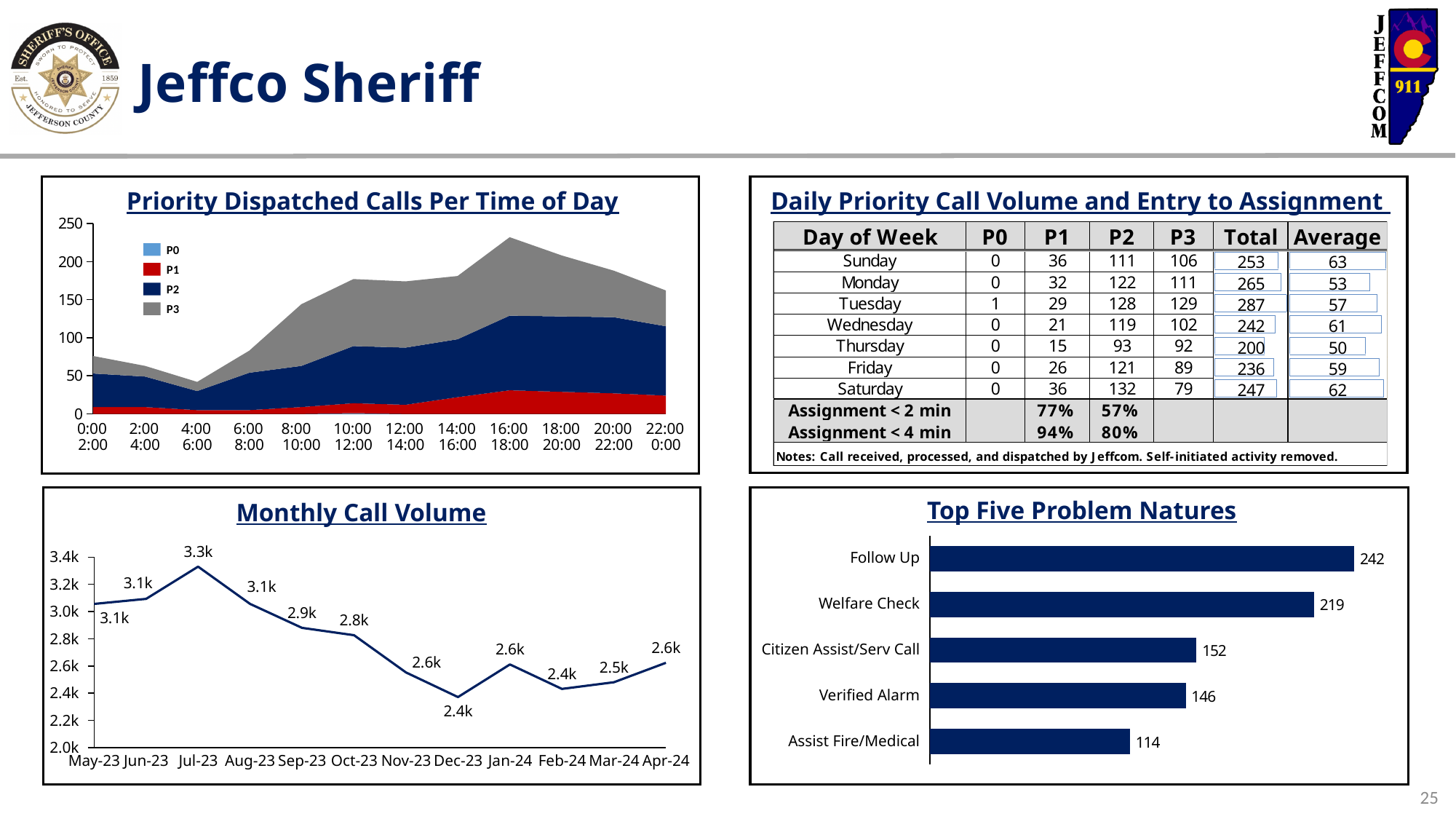
In the Top Five Problem Natures chart, what is the value for Welfare Check? 219 In the Priority Dispatched Calls Per Time of Day chart, is the total stacked value for the 16:00-18:00 period greater or less than 200? greater In the Top Five Problem Natures chart, which problem nature has the lowest value? Assist Fire/Medical How many series does the legend of the Priority Dispatched Calls Per Time of Day chart list? 4 In the Monthly Call Volume chart, do values rise or fall from Jul-23 to Dec-23? Fall In the Top Five Problem Natures chart, which problem nature has the highest value? Follow Up In the Monthly Call Volume chart, which is larger, Sep-23 or Oct-23? Sep-23 What kind of chart is the Top Five Problem Natures chart? Bar chart How many months are plotted in the Monthly Call Volume chart? 12 In the Top Five Problem Natures chart, what is the difference between Follow Up and Welfare Check? 23 What kind of chart is the Priority Dispatched Calls Per Time of Day chart? Stacked area chart In the Monthly Call Volume chart, what is the value for Jul-23? 3.3k